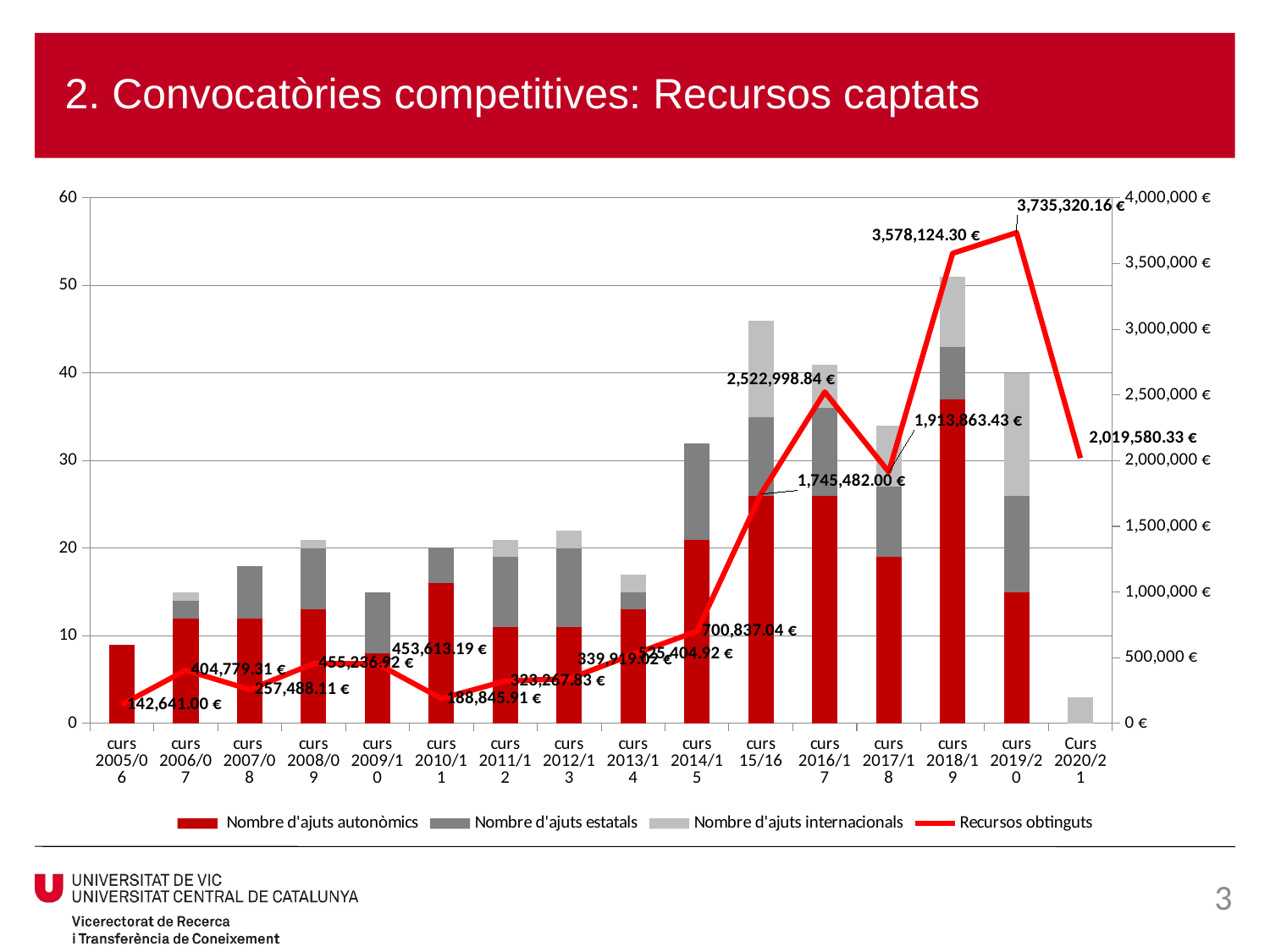
In which curs is Recursos obtinguts lowest? curs 2005/06 Which has a larger Recursos obtinguts value, curs 2015/16 or curs 2016/17? curs 2016/17 How many curs categories are shown on the x axis? 16 What is the value of Recursos obtinguts for curs 2005/06? 142,641.00 € What is the value of Recursos obtinguts for Curs 2020/21? 2,019,580.33 € What kind of chart is this? Combination of stacked bar chart and line chart How many series does the legend list? 4 In which curs is Recursos obtinguts highest? curs 2019/20 What is the difference in Recursos obtinguts between curs 2019/20 and curs 2018/19? 157,195.86 € What is the value of Recursos obtinguts for curs 2015/16? 1,745,482.00 € What is the value of Recursos obtinguts for curs 2019/20? 3,735,320.16 € Is the total height of the stacked bar for curs 2015/16 greater or less than 40 on the left axis? greater